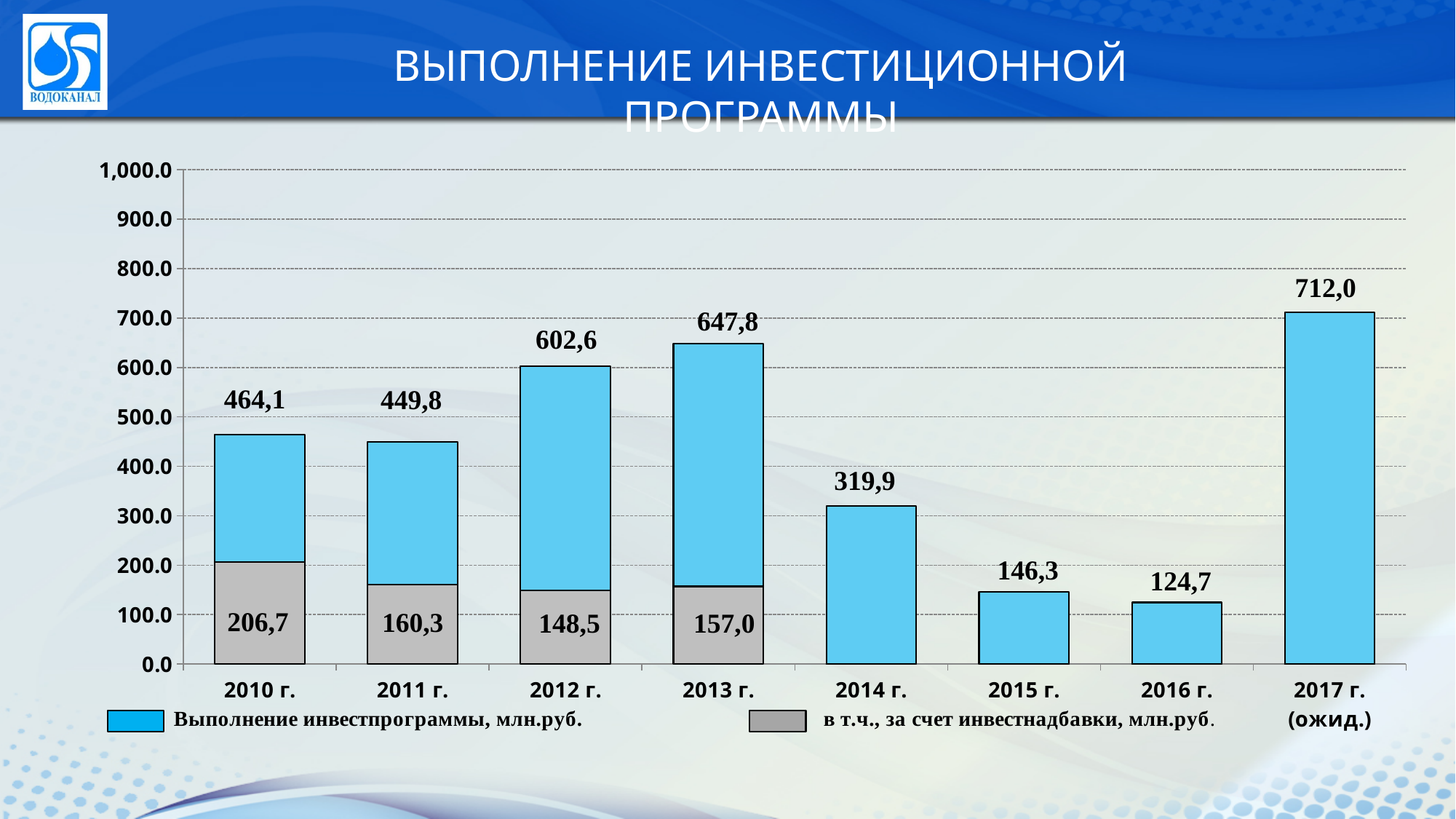
Is the value of "Выполнение инвестпрограммы, млн.руб." for 2014 г. greater or less than 400.0? less What kind of chart is shown on the slide? bar chart What is the difference between the "Выполнение инвестпрограммы, млн.руб." values for 2013 г. and 2012 г.? 45,2 What is the value of "в т.ч., за счет инвестнадбавки, млн.руб." for 2010 г.? 206,7 Which year has the lowest value of "Выполнение инвестпрограммы, млн.руб."? 2016 г. Which year has the highest value of "Выполнение инвестпрограммы, млн.руб."? 2017 г. (ожид.) Which colour represents "в т.ч., за счет инвестнадбавки, млн.руб." in the legend? grey Which is larger: the "в т.ч., за счет инвестнадбавки, млн.руб." value for 2011 г. or for 2013 г.? 2011 г. What is the value of "Выполнение инвестпрограммы, млн.руб." for 2013 г.? 647,8 How many series does the legend list? 2 How many years are shown on the x axis? 8 What is the value of "Выполнение инвестпрограммы, млн.руб." for 2016 г.? 124,7